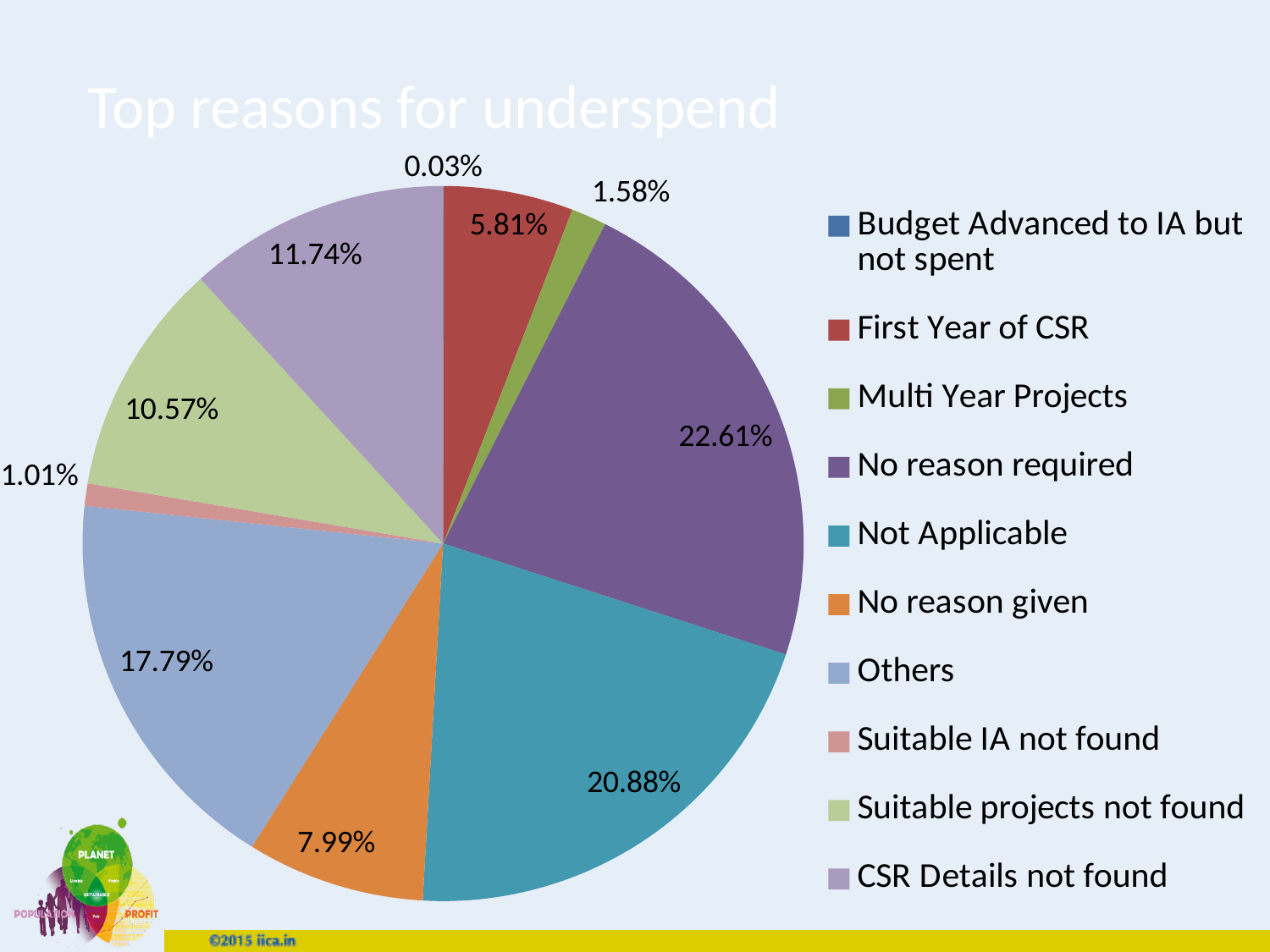
What share of the pie is 'First Year of CSR'? 5.81% What share of the pie is 'Others'? 17.79% What share of the pie is 'No reason required'? 22.61% What is the difference between the shares for 'No reason required' and 'Not Applicable'? 1.73% Which category has the smallest share of the pie? Budget Advanced to IA but not spent What type of chart is shown on the slide? pie chart What is the title of the chart? Top reasons for underspend What share of the pie is 'Not Applicable'? 20.88% What share of the pie is 'Suitable projects not found'? 10.57% Which is larger, the share for 'CSR Details not found' or the share for 'No reason given'? CSR Details not found How many categories does the legend list? 10 Which category has the largest share of the pie? No reason required